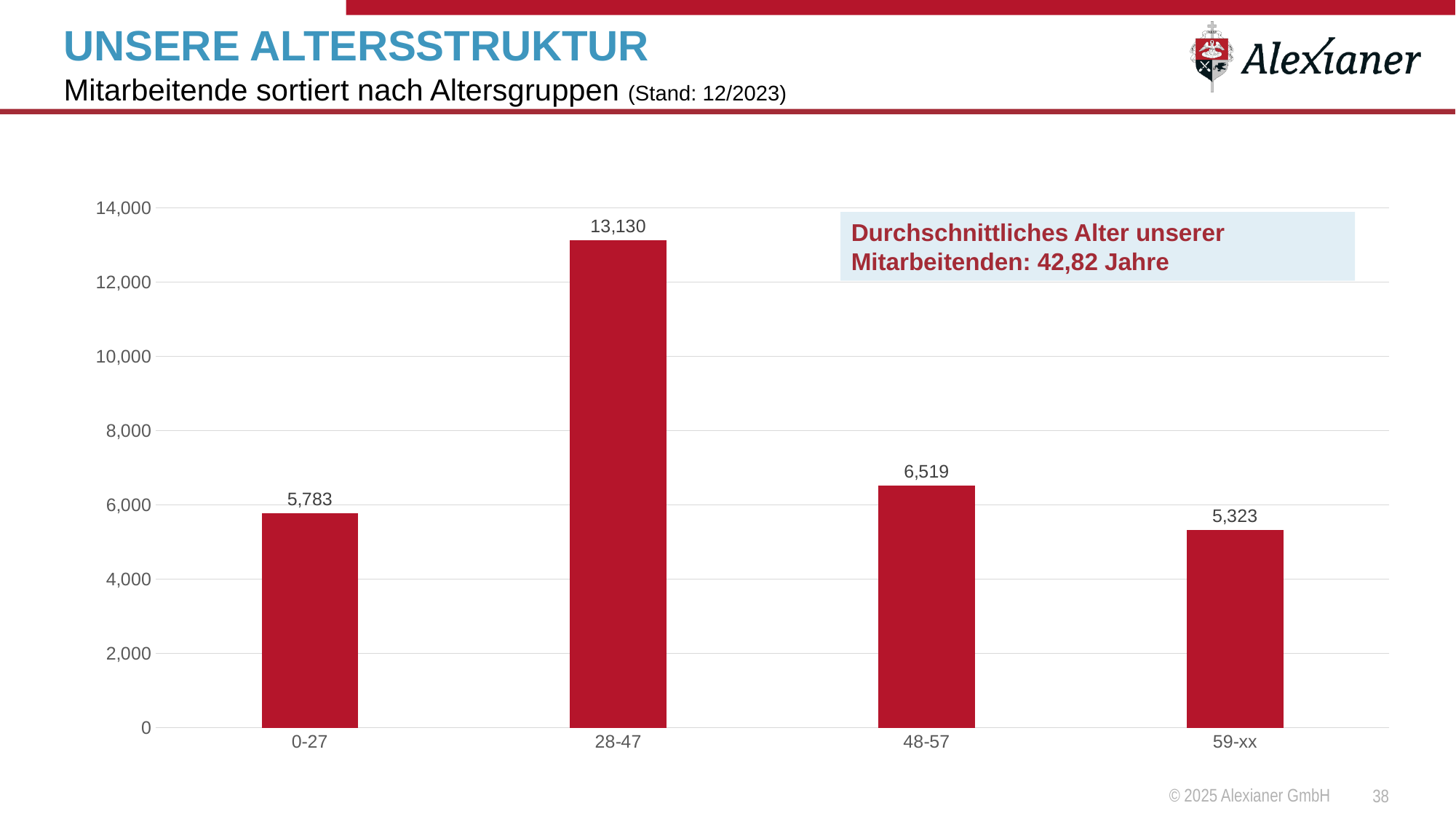
Which age group has the most employees? 28-47 How many employees are in the 59-xx age group? 5,323 What kind of chart is shown on the slide? bar chart How many employees are in the 0-27 age group? 5,783 Which age group has more employees, 0-27 or 48-57? 48-57 How many employees are in the 48-57 age group? 6,519 What is the difference between the number of employees in the 28-47 group and the 48-57 group? 6,611 How many employees are in the 28-47 age group? 13,130 Is the value for the 59-xx age group greater or less than 6,000? less How many age groups are shown in the chart? 4 Which age group has the fewest employees? 59-xx What is the average age of employees stated on the slide? 42,82 Jahre